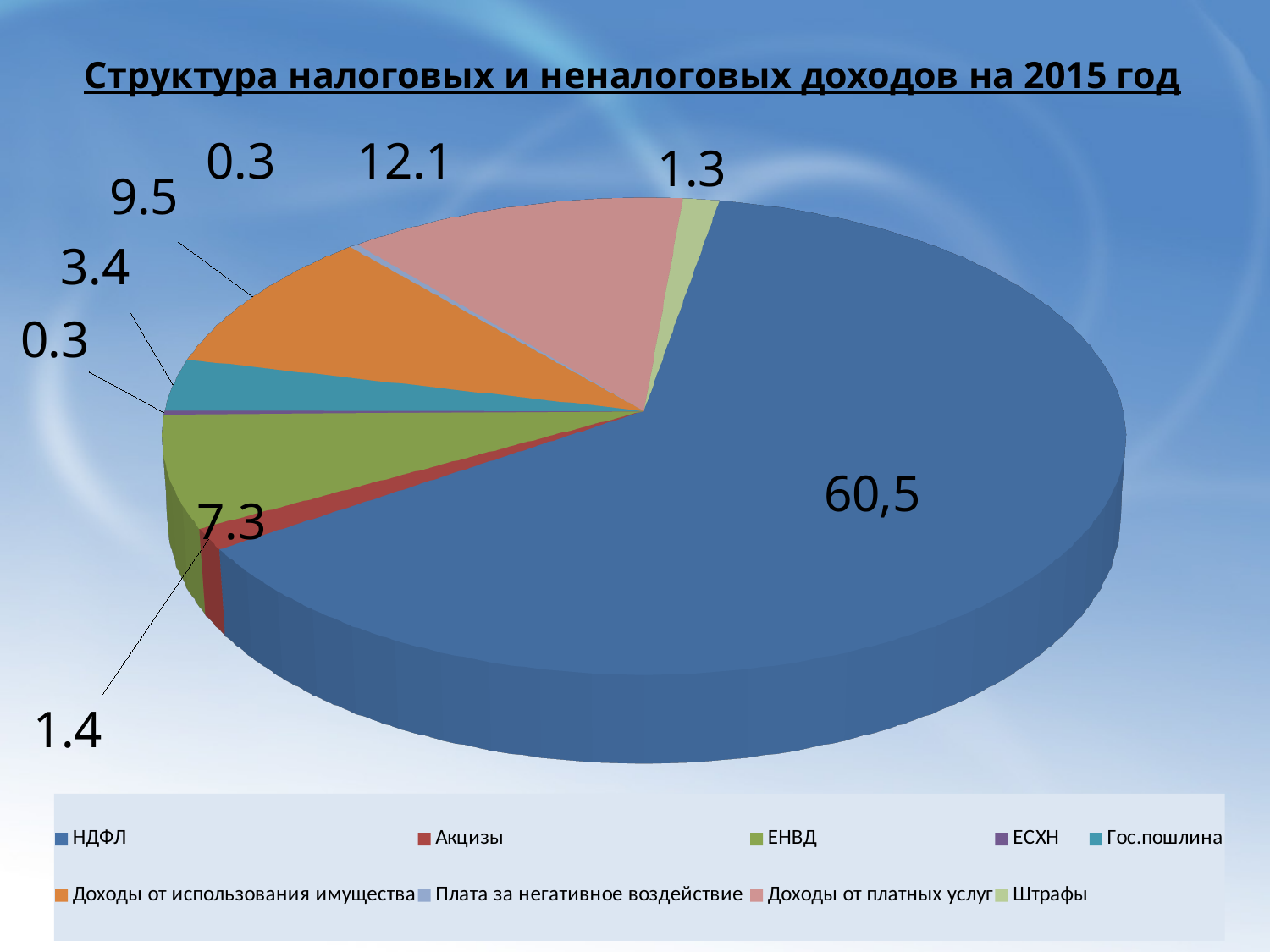
What is the value shown for Доходы от платных услуг? 12.1 How many categories does the legend list? 9 What is the value shown for Доходы от использования имущества? 9.5 What kind of chart is shown on the slide? pie chart What is the title of the chart? Структура налоговых и неналоговых доходов на 2015 год Which is larger, the value for Доходы от платных услуг or the value for Доходы от использования имущества? Доходы от платных услуг What is the value shown for Штрафы? 1.3 What is the value shown for НДФЛ? 60,5 What is the value shown for Гос.пошлина? 3.4 What is the difference between the values for ЕНВД and Гос.пошлина? 3.9 Which category has the largest slice of the pie? НДФЛ What is the value shown for ЕНВД? 7.3